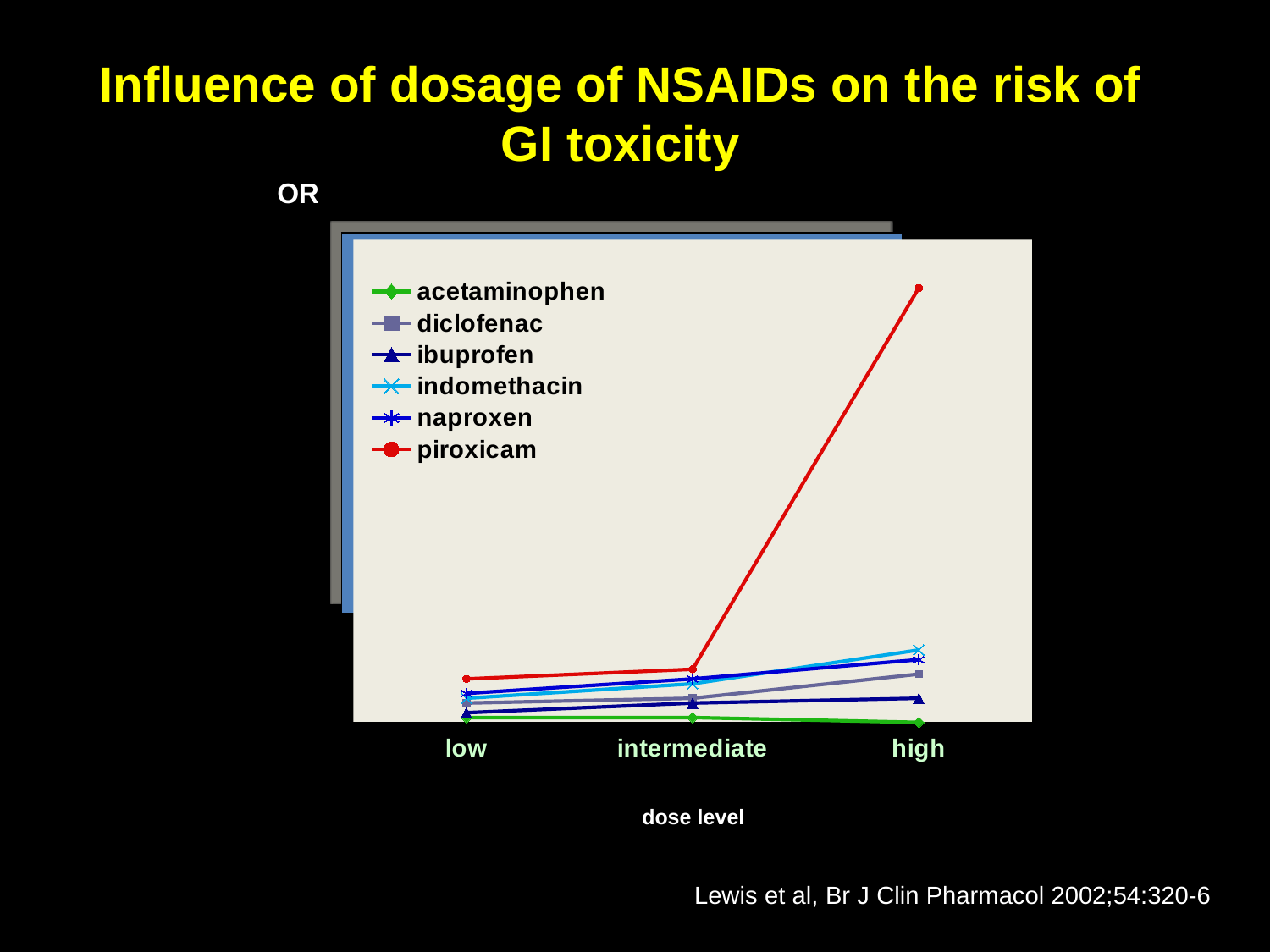
What colour is the line for piroxicam? red At the high dose level, which is larger, the OR for piroxicam or the OR for ibuprofen? piroxicam What kind of chart is shown on the slide? line chart How many series does the legend list? 6 Which drug has the lowest OR at the high dose level? acetaminophen How many dose levels are shown on the x axis? 3 Does the OR for piroxicam rise or fall from low to high dose level? rise Which drug has the highest OR at the high dose level? piroxicam What is the label of the x axis? dose level Does the OR for indomethacin rise or fall from low to high dose level? rise Which drug has the highest OR at the low dose level? piroxicam At the high dose level, which is larger, the OR for indomethacin or the OR for acetaminophen? indomethacin